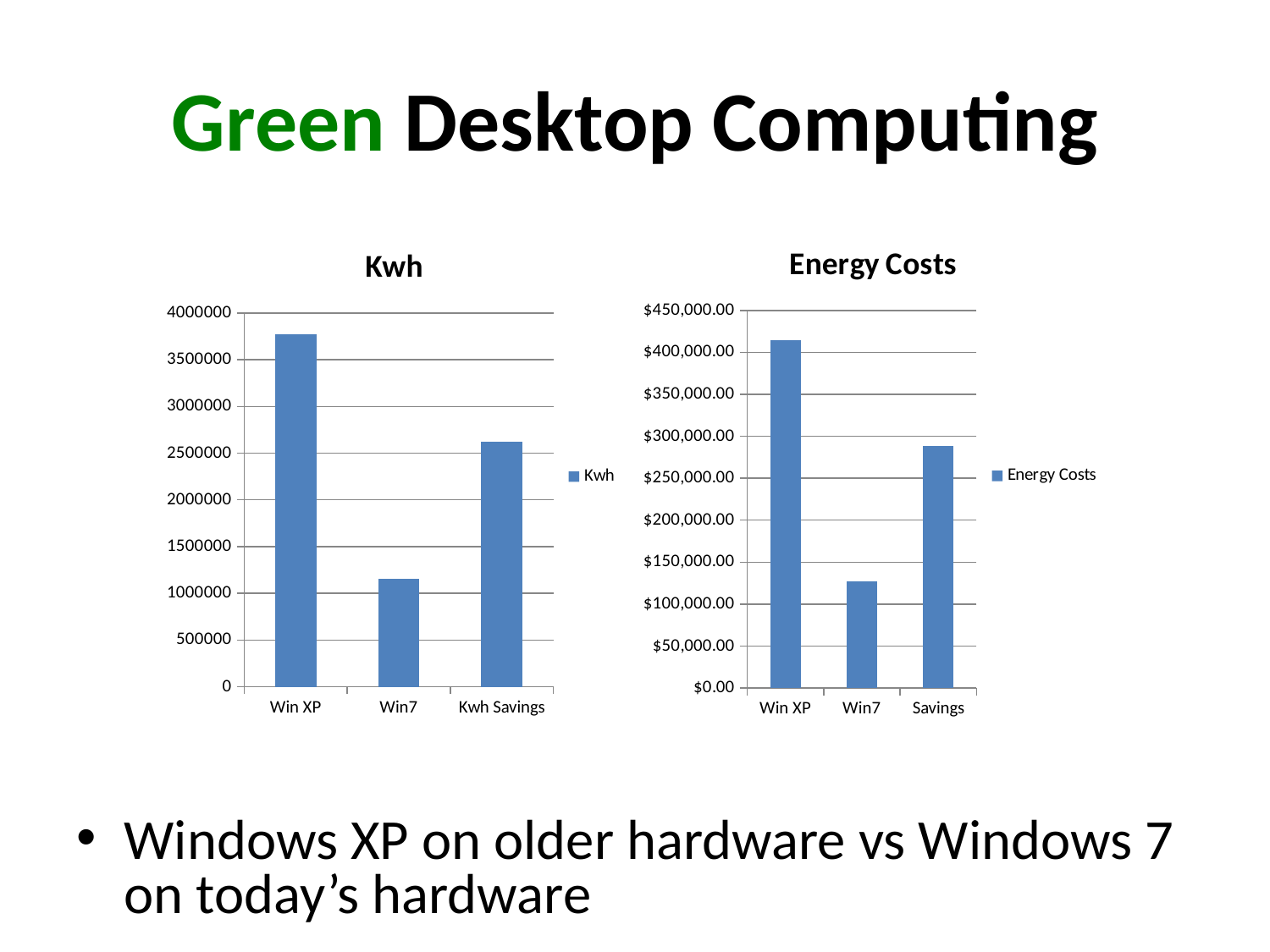
In the Kwh chart, is the value for Kwh Savings greater or less than 2500000? greater In the Kwh chart, which category has the lowest value? Win7 In the Energy Costs chart, is the value for Savings greater or less than $250,000.00? greater In the Kwh chart, is the value for Win7 greater or less than 1500000? less In the Energy Costs chart, which is larger, the value for Win7 or the value for Savings? Savings How many categories are shown on the x axis of the Kwh chart? 3 In the Kwh chart, which category has the highest value? Win XP What kind of chart is the Energy Costs chart? bar chart In the Energy Costs chart, which category has the highest value? Win XP In the Energy Costs chart, which category has the lowest value? Win7